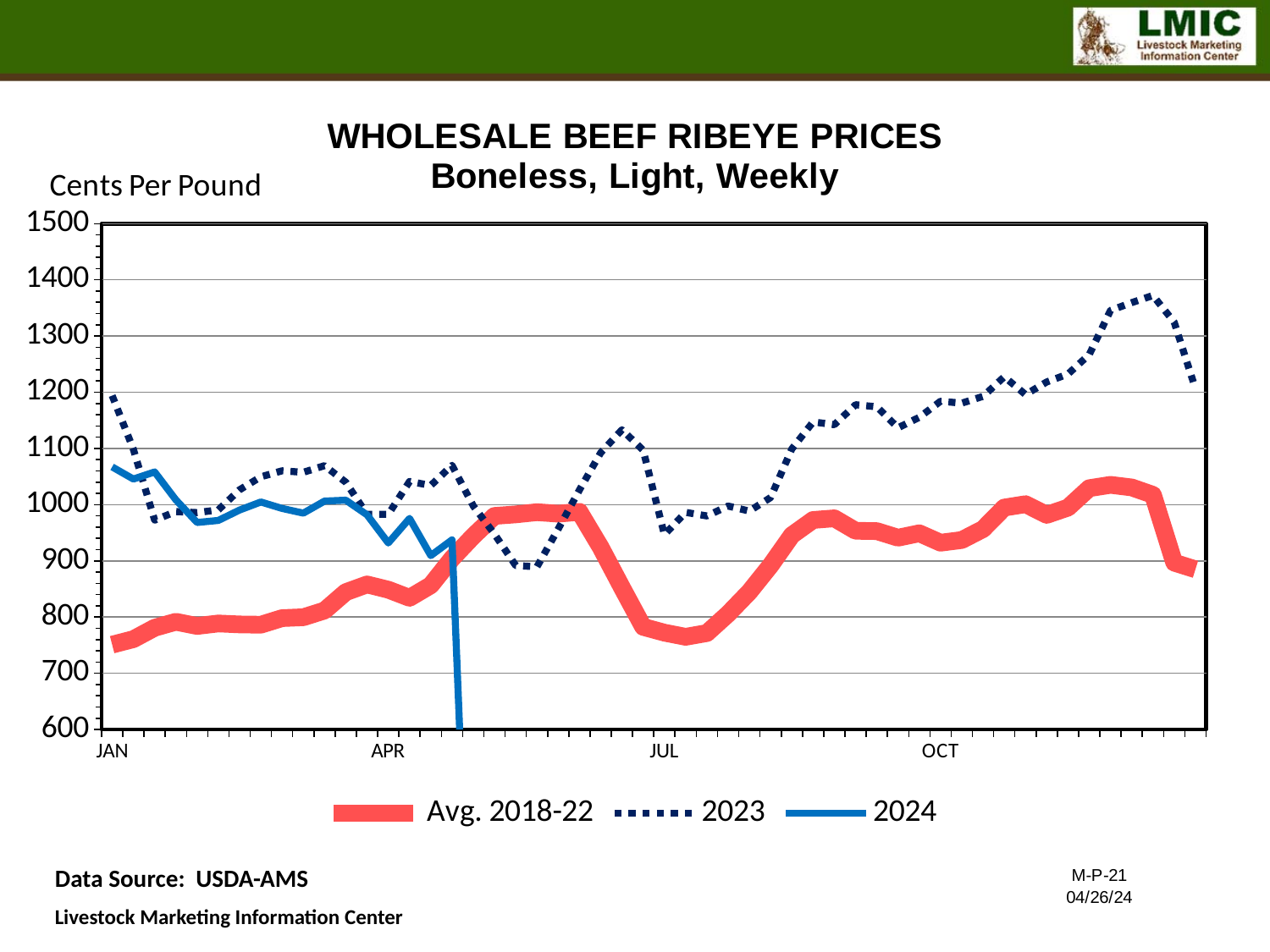
What kind of chart is shown on the slide? Line chart Is the 2023 value at the start of January greater or less than 1100? greater What is the title of the chart? WHOLESALE BEEF RIBEYE PRICES Boneless, Light, Weekly How many month labels are shown on the x axis? 4 At the start of January, which is higher: the 2023 line or the Avg. 2018-22 line? 2023 How many series does the legend list? 3 Is the Avg. 2018-22 value at the start of January greater or less than 800? less Which series reaches the highest value on the chart? 2023 Does the Avg. 2018-22 line rise or fall from JAN to APR? rise Is the 2024 value at the start of January greater or less than 1000? greater What unit is shown on the vertical axis label? Cents Per Pound